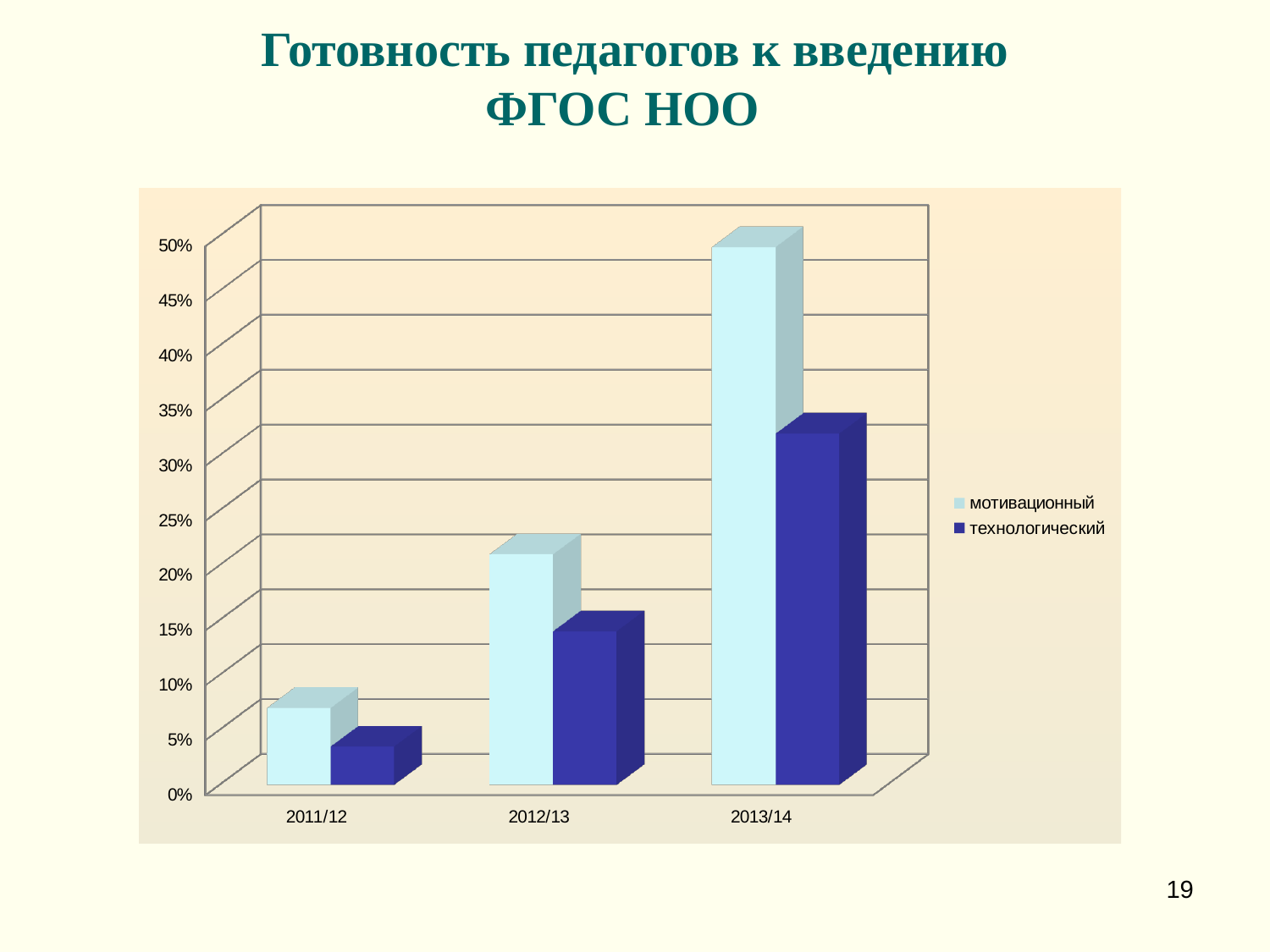
Is the value for мотивационный in 2011/12 greater or less than 10%? less How many categories (academic years) are shown on the x axis? 3 Which academic year has the highest value for мотивационный? 2013/14 Is the value for мотивационный in 2013/14 greater or less than 45%? greater In 2013/14, which is larger: мотивационный or технологический? мотивационный Is the value for технологический in 2013/14 greater or less than 25%? greater Which academic year has the lowest value for технологический? 2011/12 What kind of chart is shown on the slide? bar chart Do the values for мотивационный rise or fall from 2011/12 to 2013/14? rise Which series is shown in dark blue in the legend? технологический How many series does the legend list? 2